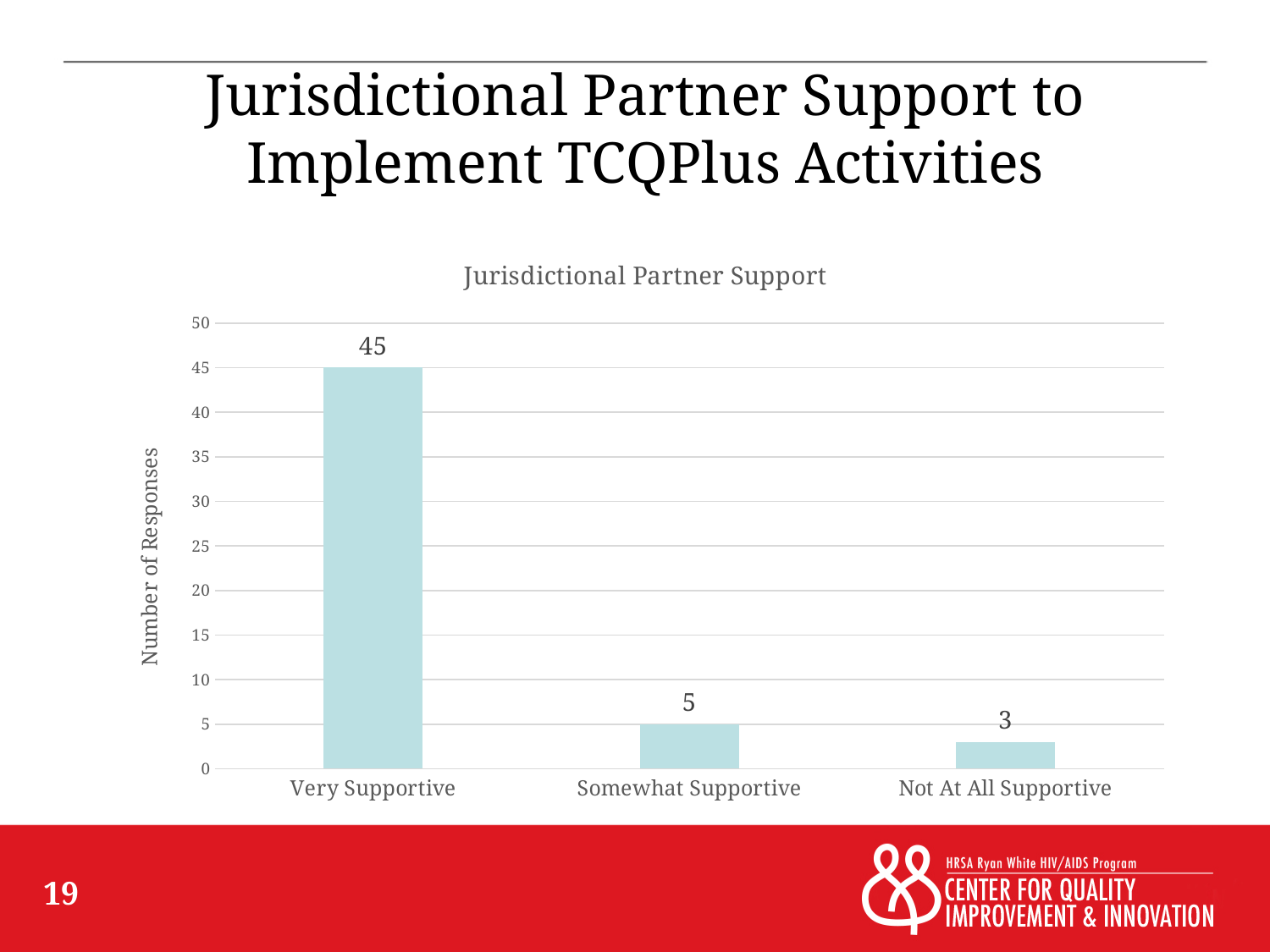
Which has more responses, Somewhat Supportive or Not At All Supportive? Somewhat Supportive What is the difference in responses between Very Supportive and Somewhat Supportive? 40 What kind of chart is shown on the slide? Bar chart What is the number of responses for Very Supportive? 45 What is the number of responses for Not At All Supportive? 3 How many categories are shown on the x axis? 3 What is the title of the chart? Jurisdictional Partner Support Which category has the lowest number of responses? Not At All Supportive What is the number of responses for Somewhat Supportive? 5 Is the value for Very Supportive greater or less than 40? greater Which category has the highest number of responses? Very Supportive What is the difference in responses between Somewhat Supportive and Not At All Supportive? 2